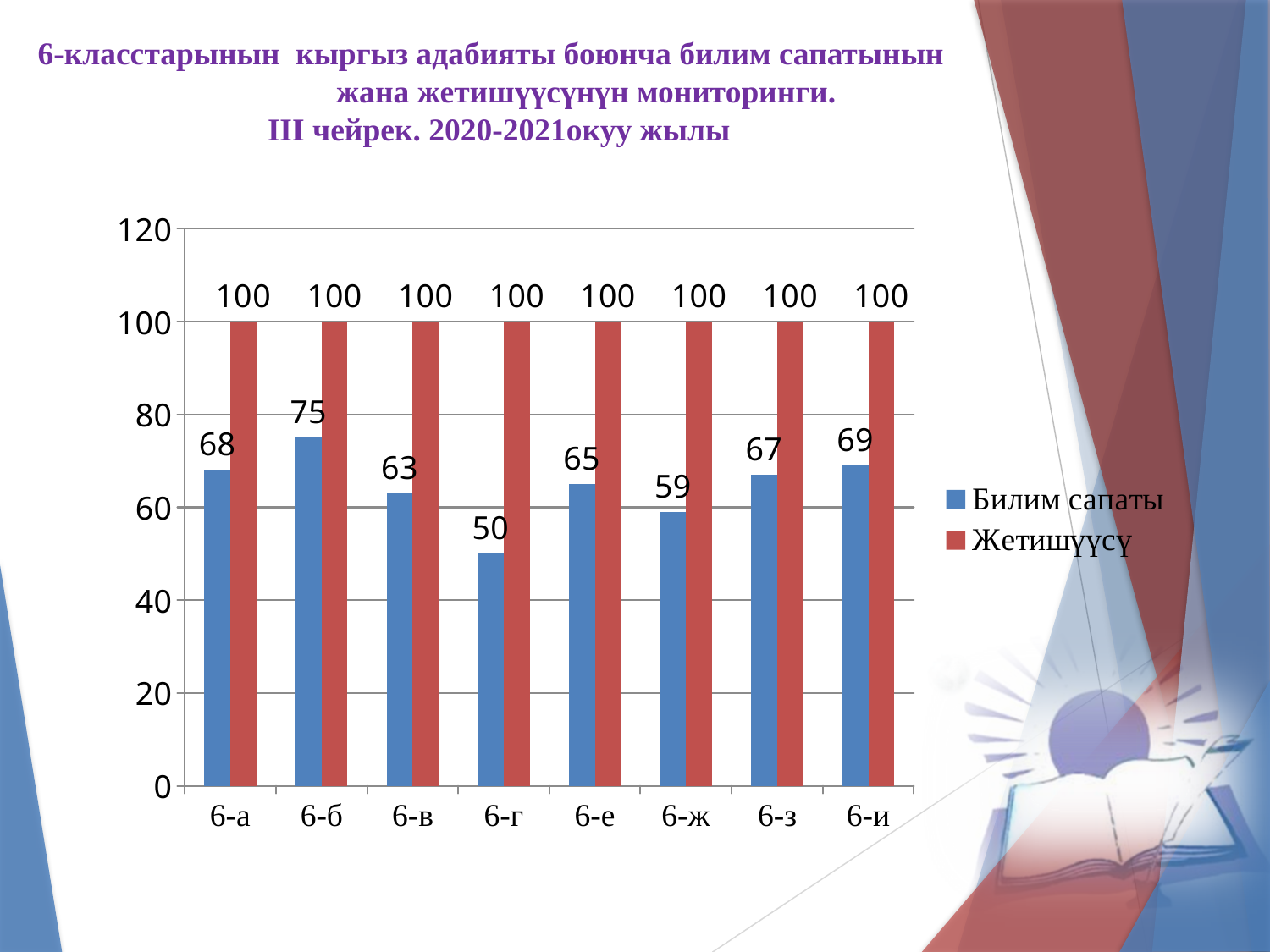
What is the Билим сапаты value for class 6-б? 75 What is the Билим сапаты value for class 6-г? 50 What kind of chart is shown on the slide? bar chart Which class has the highest Билим сапаты value? 6-б How many classes are shown on the x axis? 8 Which class has the lowest Билим сапаты value? 6-г Is the Билим сапаты value for 6-ж greater or less than 60? less What is the Жетишүүсү value for class 6-ж? 100 Which is larger, the Билим сапаты value for 6-а or for 6-и? 6-и How many series does the legend list? 2 What is the difference between the Билим сапаты values for 6-б and 6-г? 25 Which colour represents the Жетишүүсү series? red